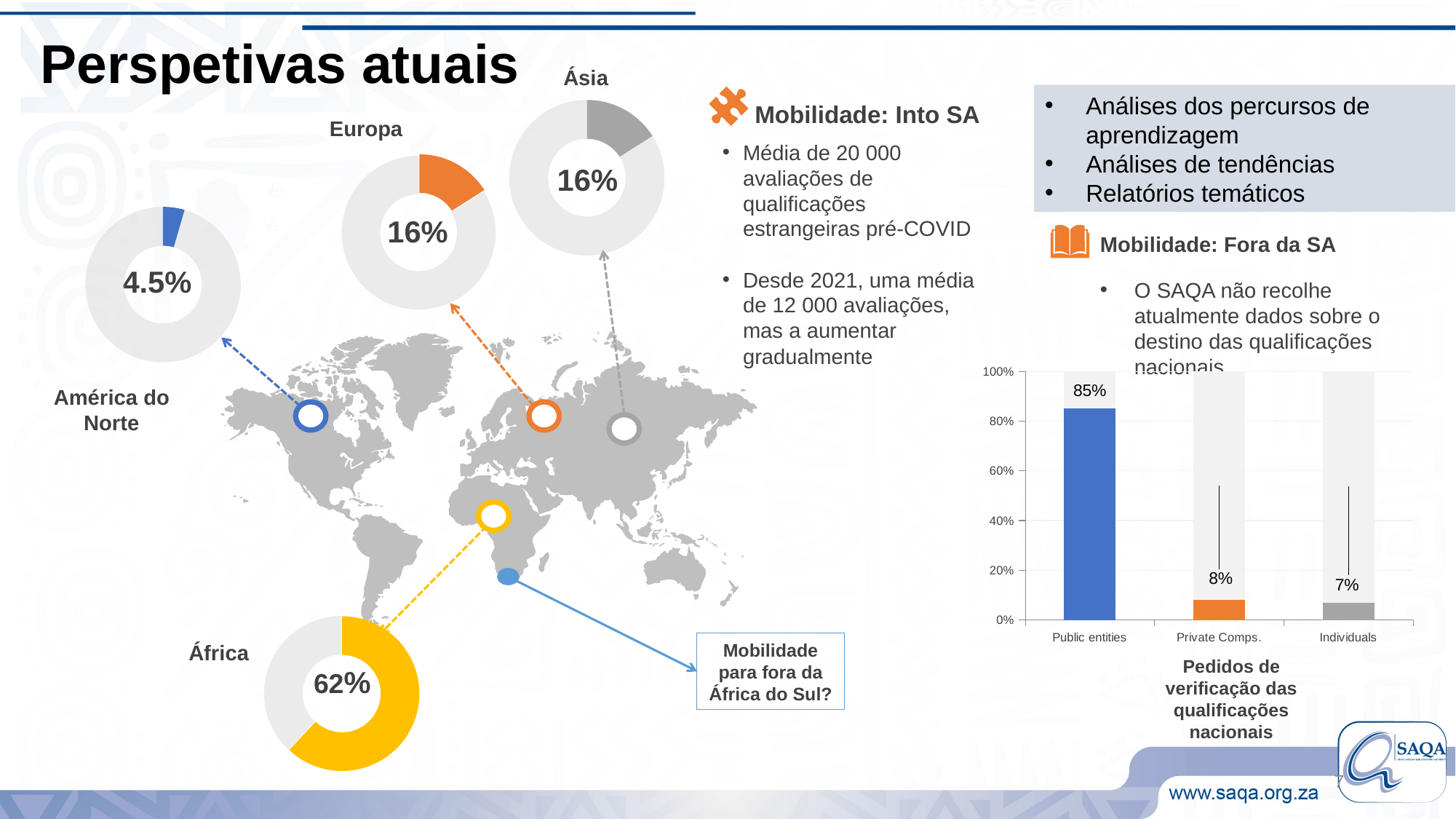
In the bar chart titled 'Pedidos de verificação das qualificações nacionais', what is the value for Public entities? 85% In the bar chart titled 'Pedidos de verificação das qualificações nacionais', what is the value for Individuals? 7% In the bar chart titled 'Pedidos de verificação das qualificações nacionais', what is the value for Private Comps.? 8% In the bar chart titled 'Pedidos de verificação das qualificações nacionais', how many categories are shown on the x axis? 3 In the bar chart titled 'Pedidos de verificação das qualificações nacionais', which category has the highest value? Public entities Among the four donut charts on the map (América do Norte, Europa, Ásia, África), which region shows the highest percentage? África In the donut chart labelled 'América do Norte', what percentage is shown? 4.5% What kind of chart is the one titled 'Pedidos de verificação das qualificações nacionais'? bar chart In the bar chart titled 'Pedidos de verificação das qualificações nacionais', what is the difference between the values for Public entities and Private Comps.? 77% Which of the donut charts on the map shows a larger percentage: Europa or América do Norte? Europa In the donut chart labelled 'África', what percentage is shown? 62% In the bar chart titled 'Pedidos de verificação das qualificações nacionais', is the value for Public entities greater or less than 80%? greater